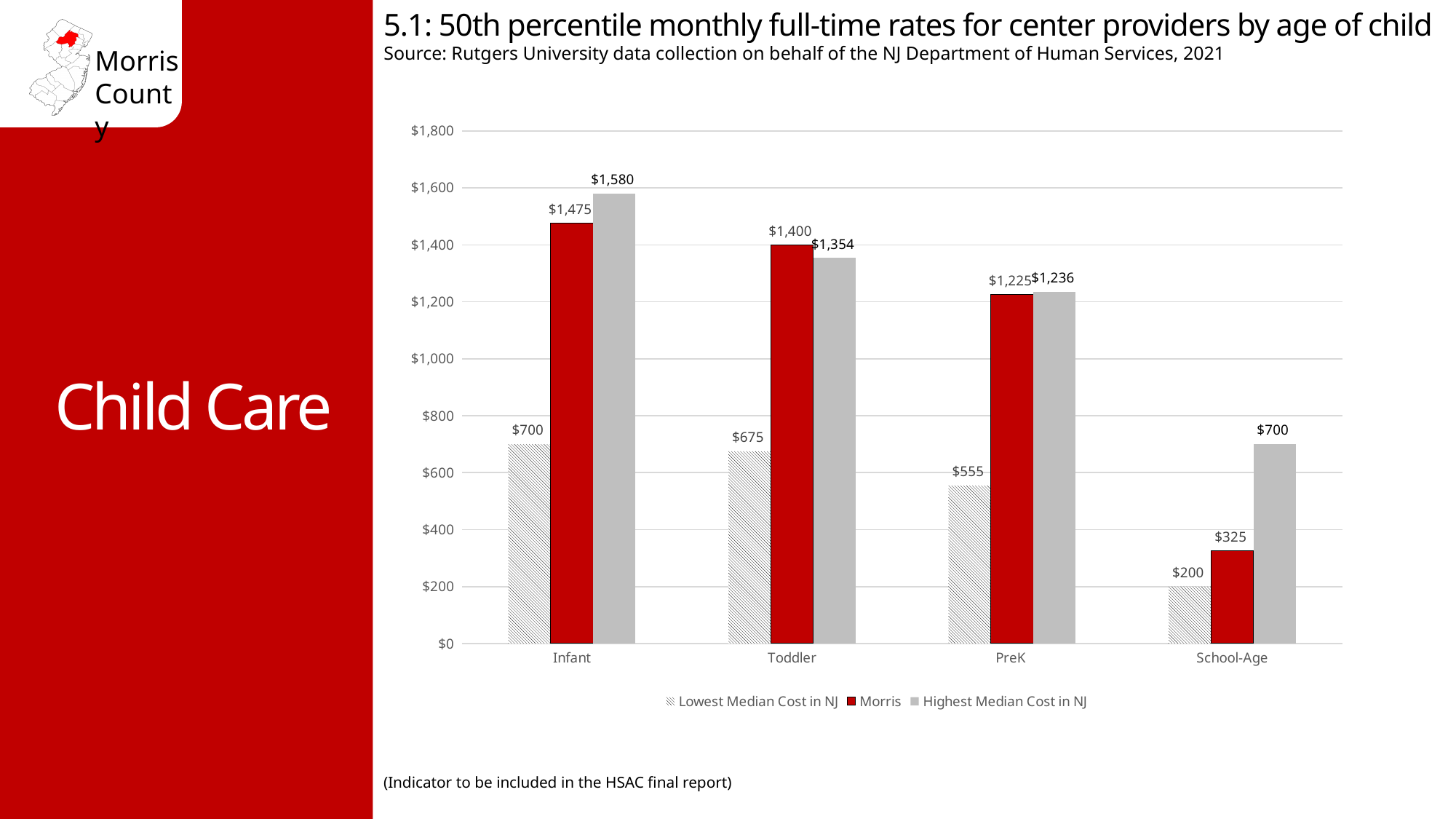
Which series is shown in red? Morris Which age category has the highest Morris value? Infant Is the Morris value for School-Age greater or less than $400? less What is the difference between the Highest Median Cost in NJ and the Morris value for Infant? $105 How many series does the legend list? 3 What is the Lowest Median Cost in NJ for PreK? $555 Which age category has the lowest Lowest Median Cost in NJ value? School-Age How many age categories are shown on the x axis? 4 What is the Highest Median Cost in NJ for School-Age? $700 For Toddler, which is larger: the Morris value or the Highest Median Cost in NJ? Morris What kind of chart is shown on the slide? bar chart What is the Morris value for Infant? $1,475